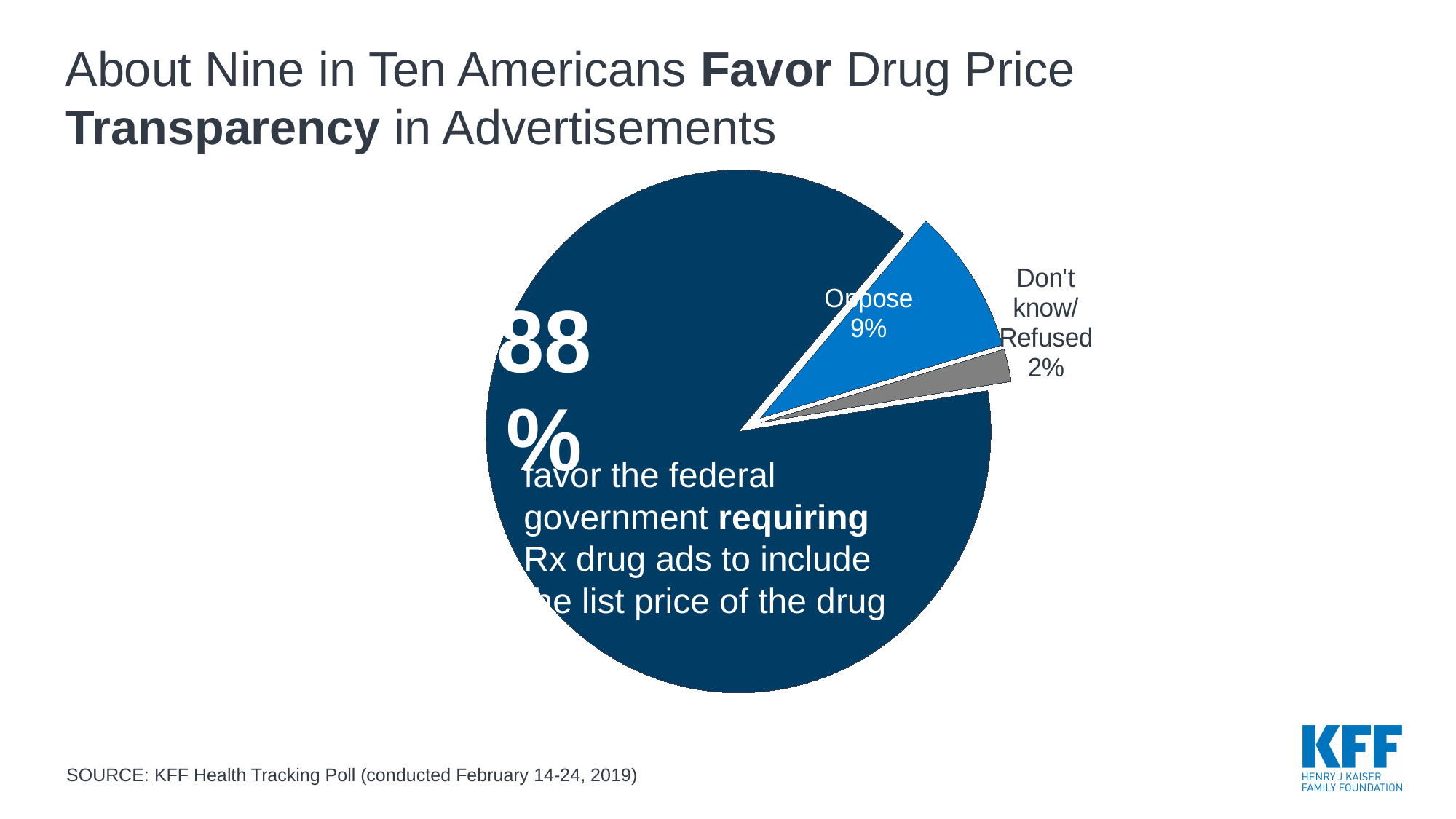
What percentage is shown for Don't know/Refused? 2% What is the difference in percentage points between those who favor and those who oppose? 79 How many slices does the pie chart have? 3 What percentage favor the federal government requiring Rx drug ads to include the list price of the drug? 88% What is the source of the data shown in the chart? KFF Health Tracking Poll (conducted February 14-24, 2019) What is the difference in percentage points between those who oppose and those who don't know/refused? 7 Which is larger, the Oppose share or the Don't know/Refused share? Oppose What kind of chart is shown on the slide? Pie chart What colour is the Oppose slice? Blue Which response has the largest share of the pie? Favor What percentage of Americans oppose requiring Rx drug ads to include the list price? 9% Which response has the smallest share of the pie? Don't know/Refused